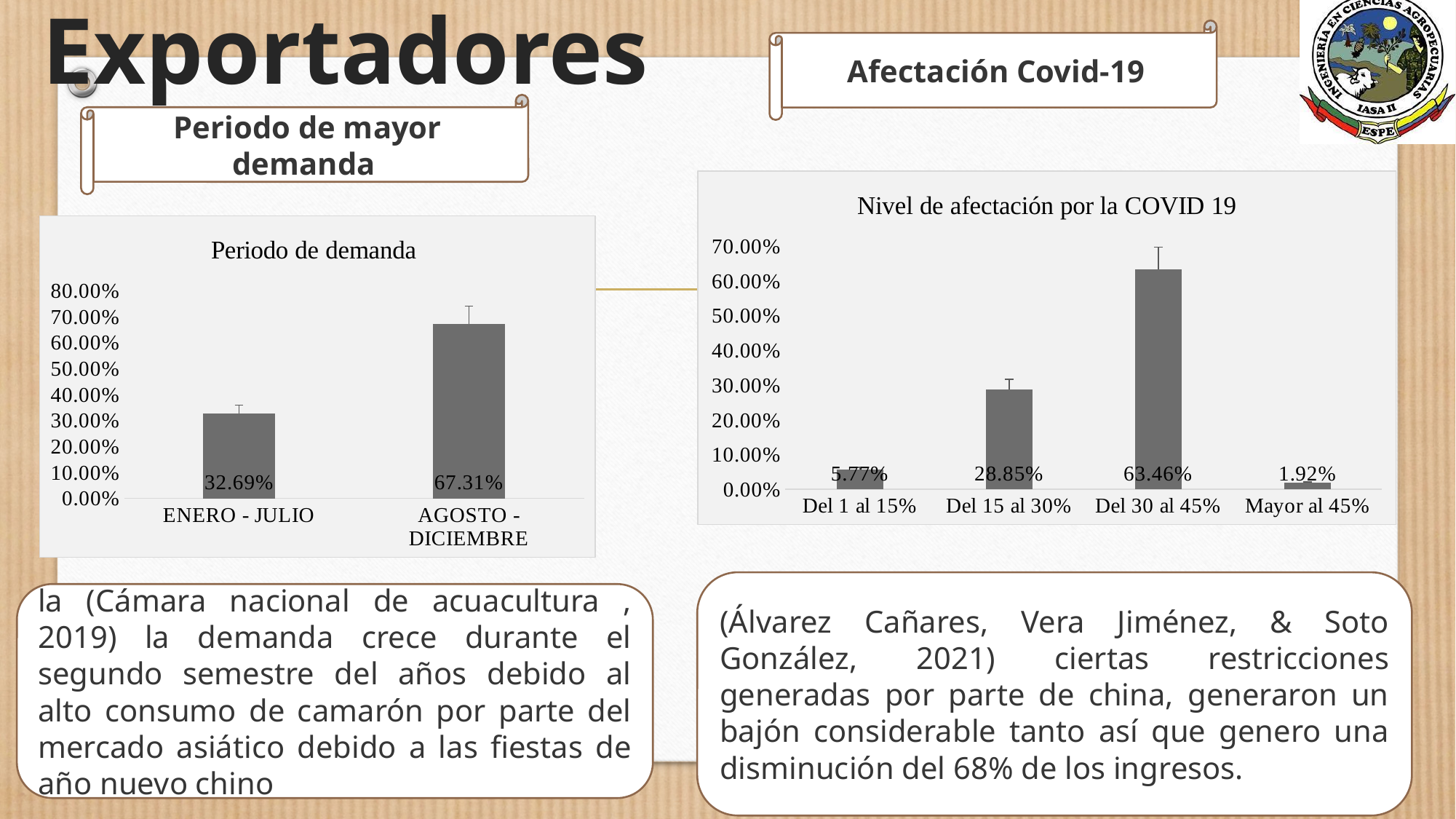
In the 'Nivel de afectación por la COVID 19' chart, how many categories are shown? 4 In the 'Periodo de demanda' chart, what is the value for ENERO - JULIO? 32.69% In the 'Nivel de afectación por la COVID 19' chart, what is the value for Del 30 al 45%? 63.46% In the 'Nivel de afectación por la COVID 19' chart, what is the value for Del 15 al 30%? 28.85% In the 'Nivel de afectación por la COVID 19' chart, which category has the highest value? Del 30 al 45% In the 'Periodo de demanda' chart, what is the value for AGOSTO - DICIEMBRE? 67.31% What type of chart is the 'Nivel de afectación por la COVID 19' chart? Bar chart In the 'Periodo de demanda' chart, how many categories are shown? 2 In the 'Periodo de demanda' chart, which period has the higher value? AGOSTO - DICIEMBRE In the 'Nivel de afectación por la COVID 19' chart, which category has the lowest value? Mayor al 45% In the 'Nivel de afectación por la COVID 19' chart, what is the difference between Del 15 al 30% and Del 1 al 15%? 23.08 percentage points In the 'Periodo de demanda' chart, what is the difference between AGOSTO - DICIEMBRE and ENERO - JULIO? 34.62 percentage points